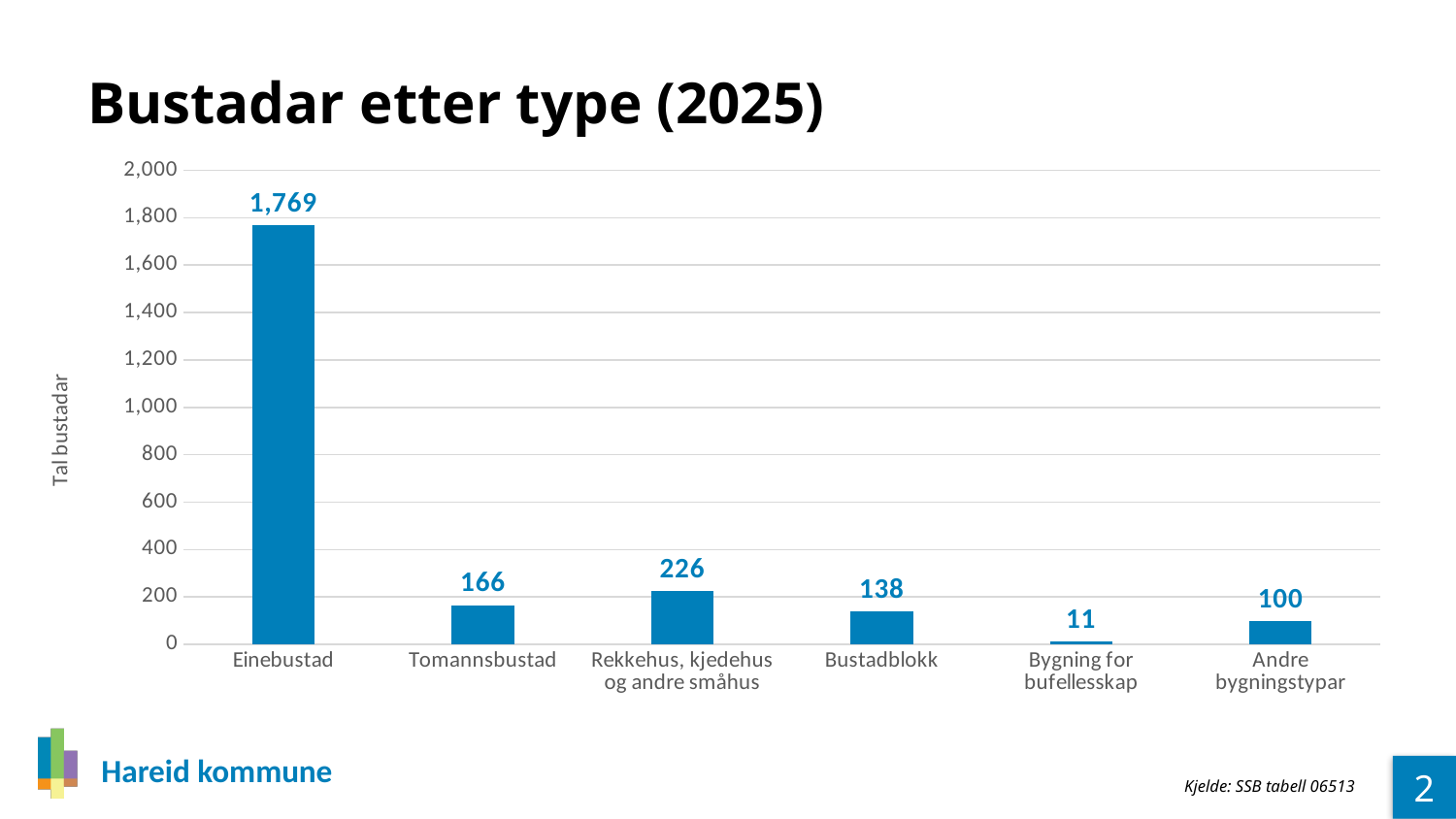
Is the value for Einebustad greater or less than 1,600? greater What is the value for Bygning for bufellesskap? 11 What kind of chart is shown on the slide? bar chart Which category has the lowest value? Bygning for bufellesskap How many categories are shown on the x axis? 6 What is the value for Rekkehus, kjedehus og andre småhus? 226 Which is larger, the value for Tomannsbustad or the value for Bustadblokk? Tomannsbustad What is the value for Einebustad? 1,769 What is the title of the chart? Bustadar etter type (2025) Which category has the highest value? Einebustad What is the difference between the values for Rekkehus, kjedehus og andre småhus and Tomannsbustad? 60 What is the value for Andre bygningstypar? 100